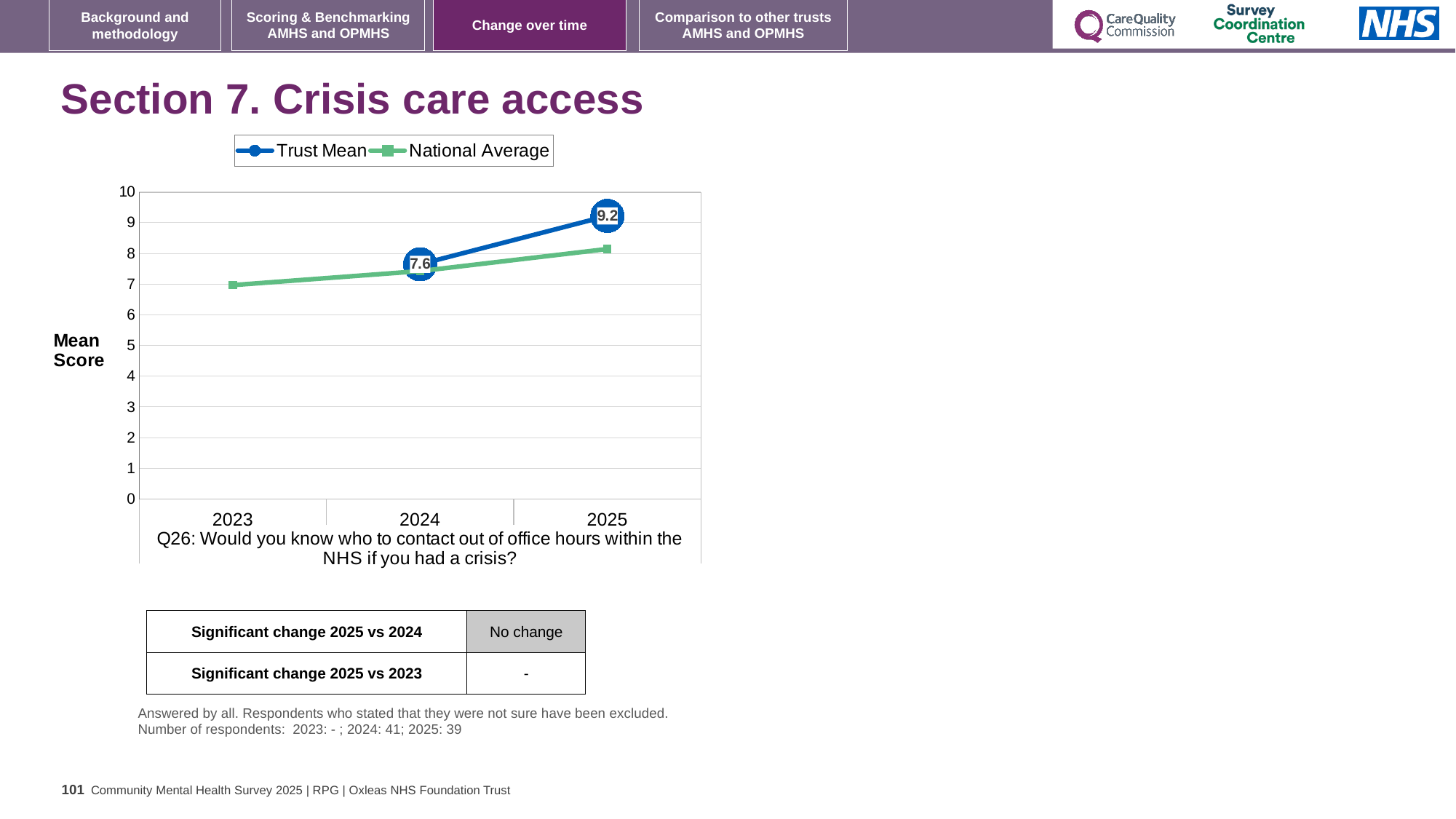
Which year has the higher Trust Mean, 2024 or 2025? 2025 How many years are shown on the x axis? 3 By how much did the Trust Mean increase from 2024 to 2025? 1.6 How many series does the legend list? 2 Is the National Average value for 2023 greater or less than 8? less What is the Trust Mean value for 2025? 9.2 What is the label on the y axis of the chart? Mean Score What kind of chart is shown on the slide? line chart Does the National Average rise or fall from 2023 to 2025? rise In 2025, which is higher, the Trust Mean or the National Average? Trust Mean What is the Trust Mean value for 2024? 7.6 Does the Trust Mean rise or fall from 2024 to 2025? rise